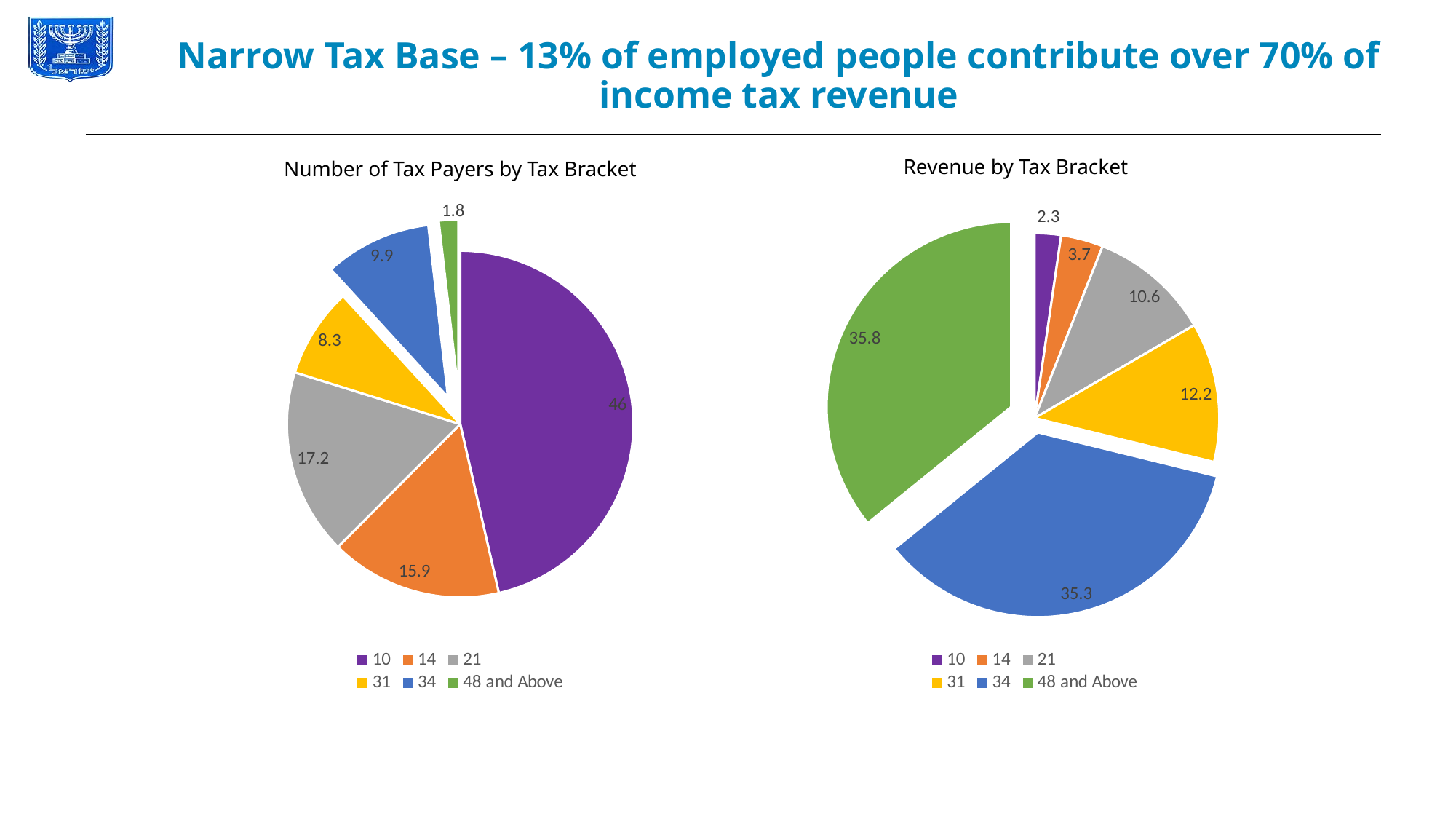
In the 'Number of Tax Payers by Tax Bracket' chart, which bracket has the largest slice? 10 In the 'Number of Tax Payers by Tax Bracket' chart, what is the difference between the values for the 21 and 14 brackets? 1.3 In the 'Revenue by Tax Bracket' chart, what is the value for the 48 and Above bracket? 35.8 In the 'Number of Tax Payers by Tax Bracket' chart, which bracket has the smallest slice? 48 and Above In the 'Revenue by Tax Bracket' chart, what colour is the slice for the 48 and Above bracket? Green In the 'Revenue by Tax Bracket' chart, which bracket has the smallest slice? 10 In the 'Number of Tax Payers by Tax Bracket' chart, what is the value for the 10 bracket? 46 In the 'Revenue by Tax Bracket' chart, what is the value for the 34 bracket? 35.3 In the 'Revenue by Tax Bracket' chart, what is the difference between the values for the 31 and 21 brackets? 1.6 How many slices does the 'Number of Tax Payers by Tax Bracket' chart have? 6 In the 'Revenue by Tax Bracket' chart, which is larger: the value for the 21 bracket or the 31 bracket? 31 What kind of chart is 'Revenue by Tax Bracket'? Pie chart